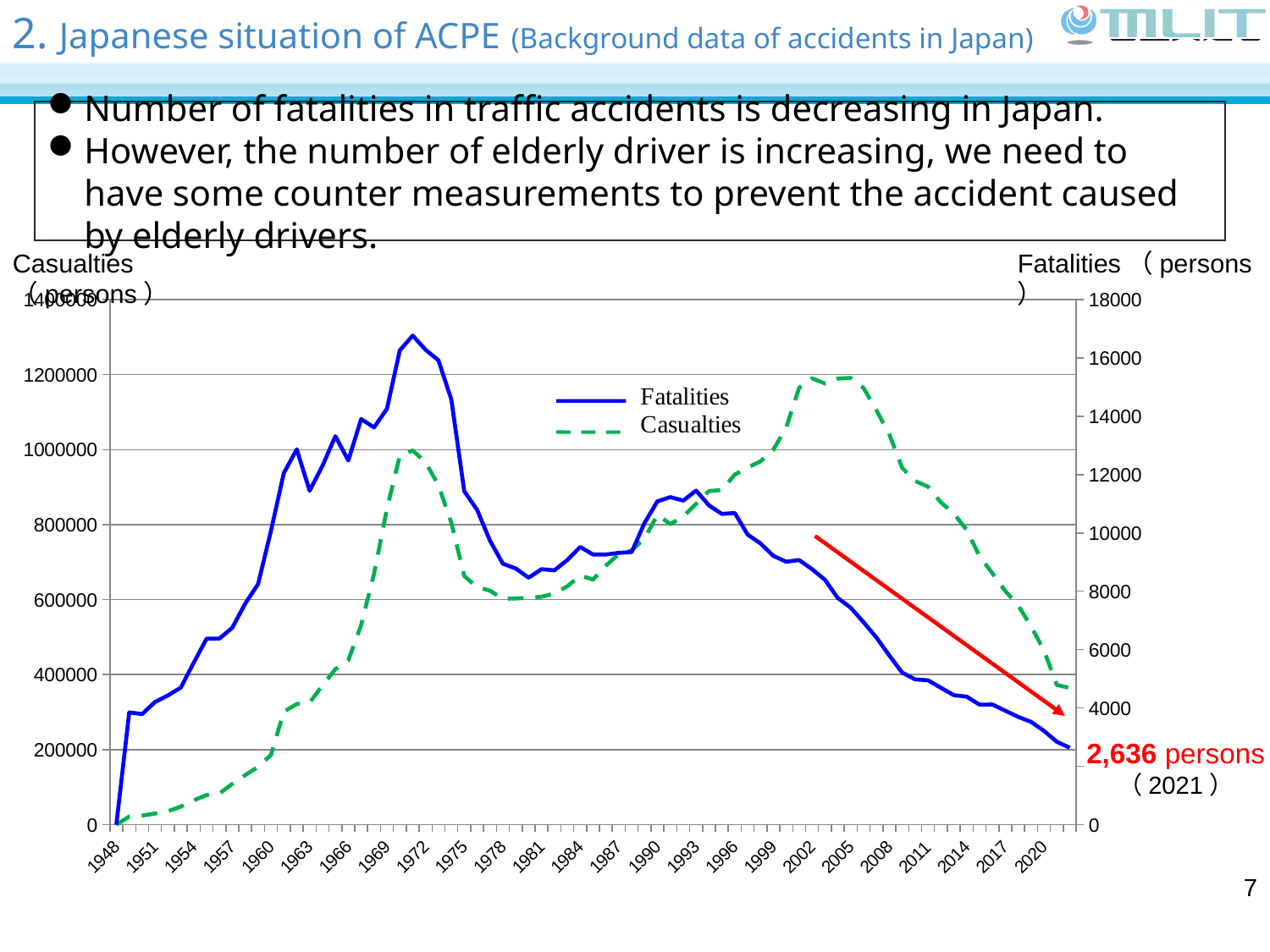
Do the Fatalities values rise or fall from 1993 to 2021? fall Is the value for Fatalities in 2020 greater or less than 4000? less What is the number of fatalities labelled on the chart for 2021? 2,636 persons How many year labels are shown on the x axis? 25 What kind of chart is shown on the slide? Line chart How many series does the chart legend list? 2 Is the value for Fatalities around 1970 greater or less than 16000? greater Is the value for Casualties around 2004 greater or less than 1000000? greater What are the two series named in the chart legend? Fatalities and Casualties Which is larger: Casualties around 2004 or Casualties around 1970? Casualties around 2004 Do the Fatalities values rise or fall from 1948 to 1970? rise